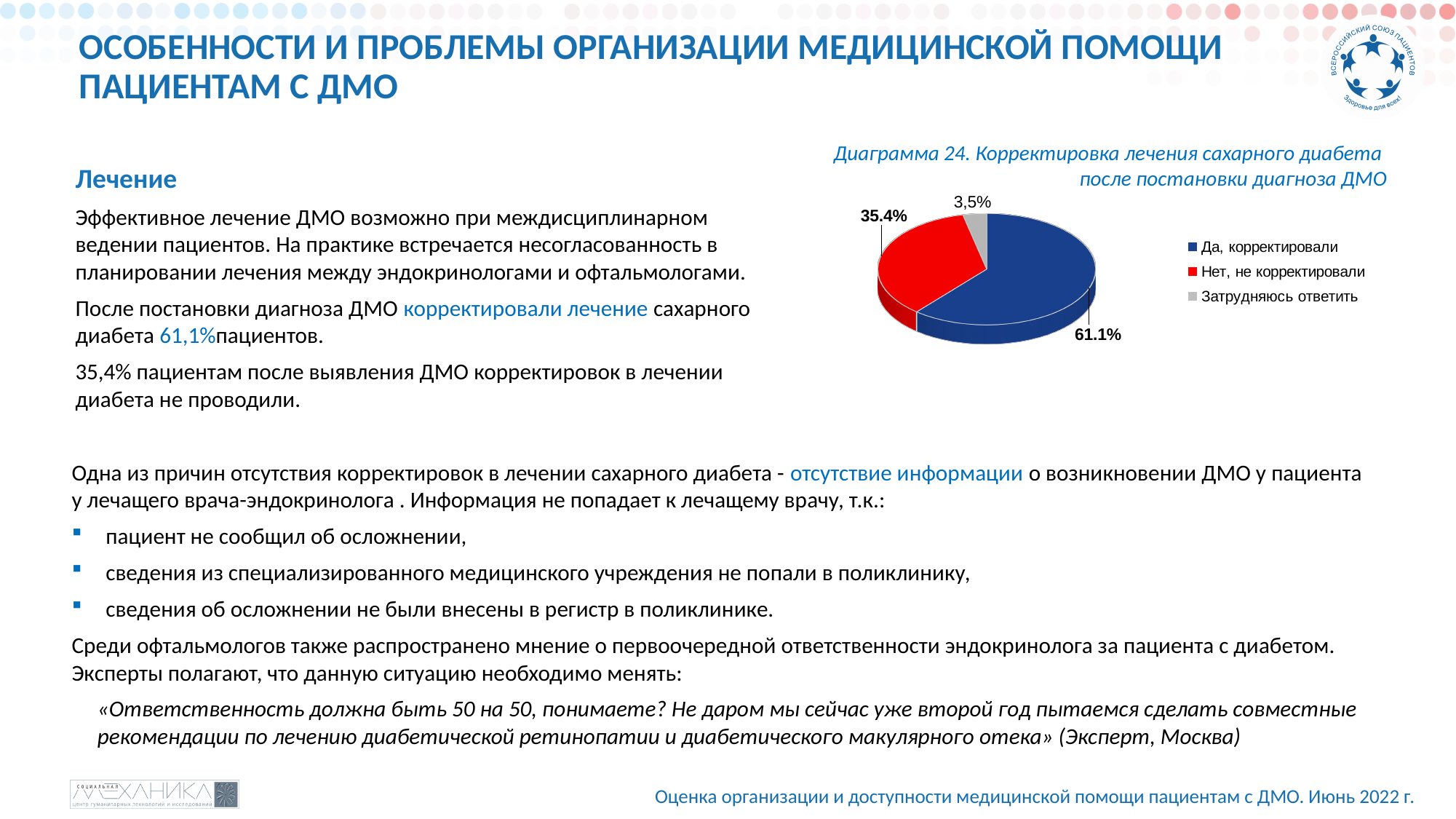
What colour is the slice for "Нет, не корректировали"? Red Which category has the largest slice of the pie? Да, корректировали Which is larger: the slice for "Да, корректировали" or the slice for "Нет, не корректировали"? Да, корректировали What is the title of the chart? Диаграмма 24. Корректировка лечения сахарного диабета после постановки диагноза ДМО What is the difference in percentage points between the "Да, корректировали" slice and the "Нет, не корректировали" slice? 25.7 How many categories does the pie chart show? 3 What type of chart is shown on the slide? Pie chart Which category has the smallest slice of the pie? Затрудняюсь ответить How many entries does the legend list? 3 What share of the pie corresponds to "Затрудняюсь ответить"? 3,5% What share of the pie corresponds to "Да, корректировали"? 61.1% What share of the pie corresponds to "Нет, не корректировали"? 35.4%